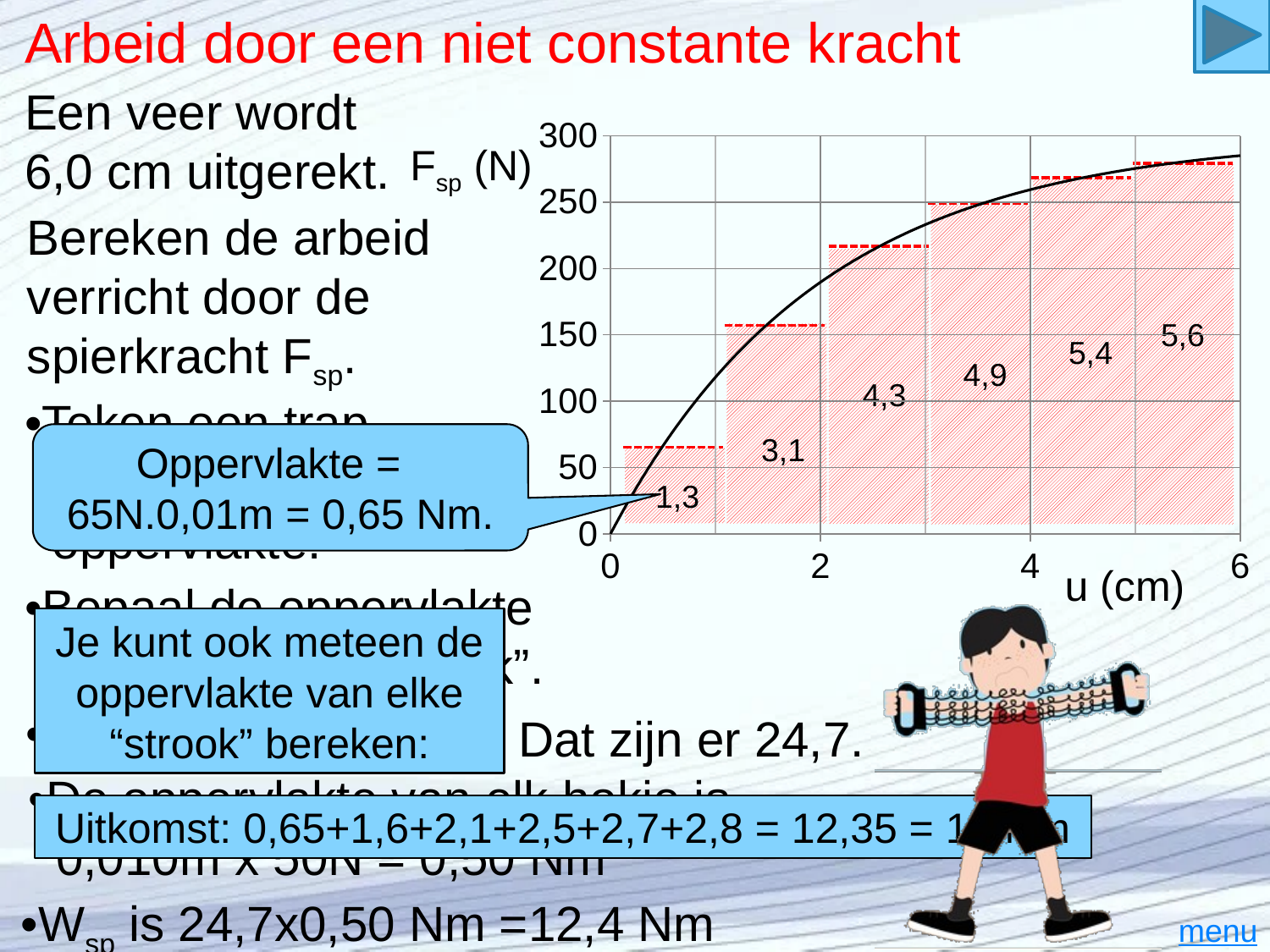
What number is printed on the second shaded strip (between u = 1 and 2 cm)? 3,1 How many shaded strips (steps) are drawn under the curve in the chart? 6 Which shaded strip has the smallest printed number? the first strip (1,3) What number is printed on the last shaded strip (between u = 5 and 6 cm)? 5,6 What is the label of the horizontal axis of the chart? u (cm) Is the value of Fsp at u = 4 cm greater or less than 250 N? greater What kind of chart is shown on the slide? line chart Does the curve of Fsp rise or fall as u increases from 0 to 6 cm? rise What number is printed on the first shaded strip (between u = 0 and 1 cm)? 1,3 What is the difference between the numbers printed on the last strip (5,6) and the first strip (1,3)? 4,3 What is the label of the vertical axis of the chart? Fsp (N) Which shaded strip has the largest printed number? the last strip (5,6)